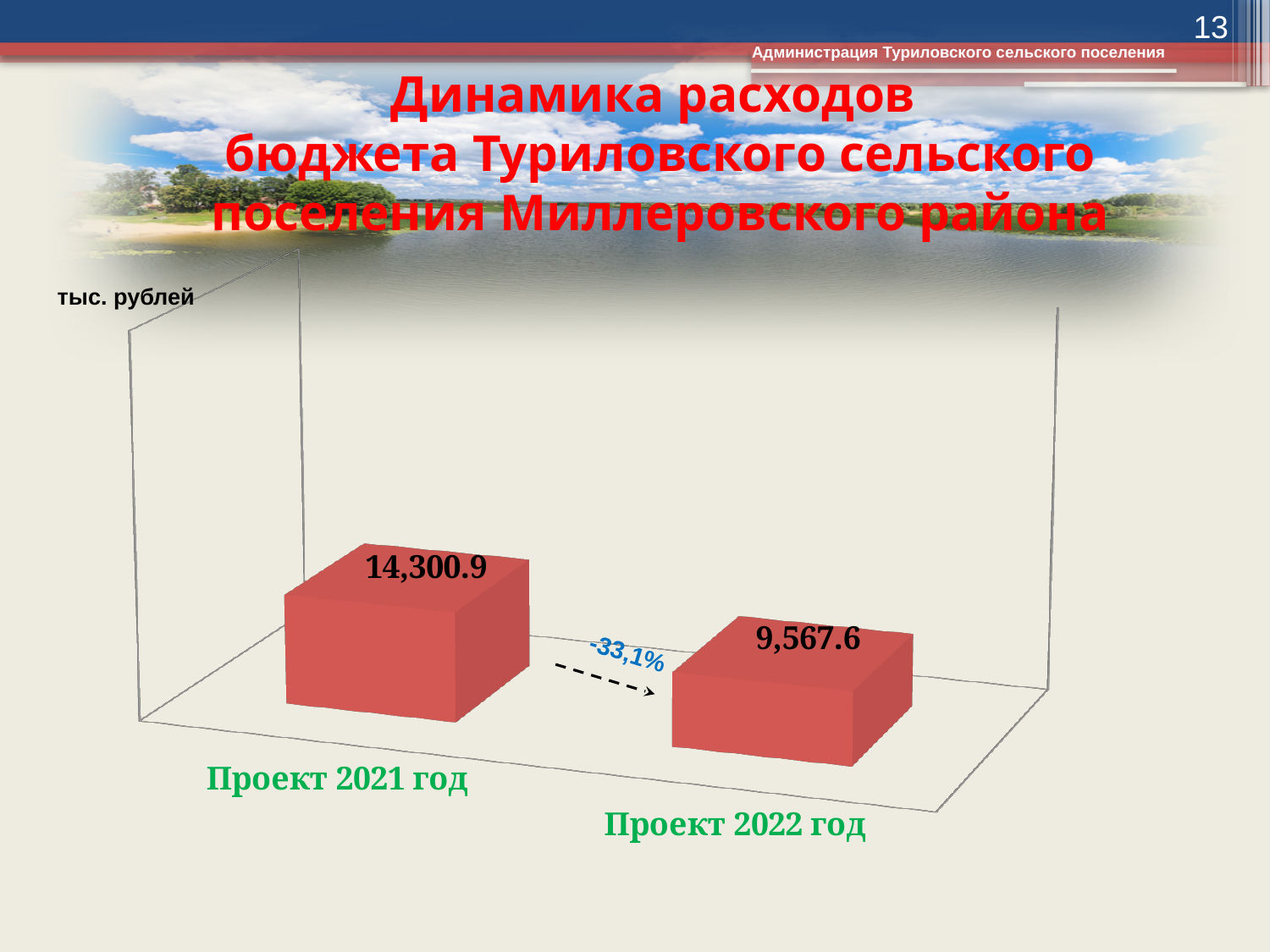
What is the value shown for Проект 2022 год? 9,567.6 What is the value shown for Проект 2021 год? 14,300.9 What unit of measurement is indicated for the chart values? тыс. рублей Which is larger, the value for Проект 2021 год or for Проект 2022 год? Проект 2021 год How many categories are plotted in the chart? 2 What percentage change is labelled on the arrow between the two bars? -33,1% Which category has the lowest value? Проект 2022 год Do the values rise or fall from Проект 2021 год to Проект 2022 год? Fall Which category has the highest value? Проект 2021 год What is the difference between the values for Проект 2021 год and Проект 2022 год? 4,733.3 What kind of chart is shown on the slide? Bar chart